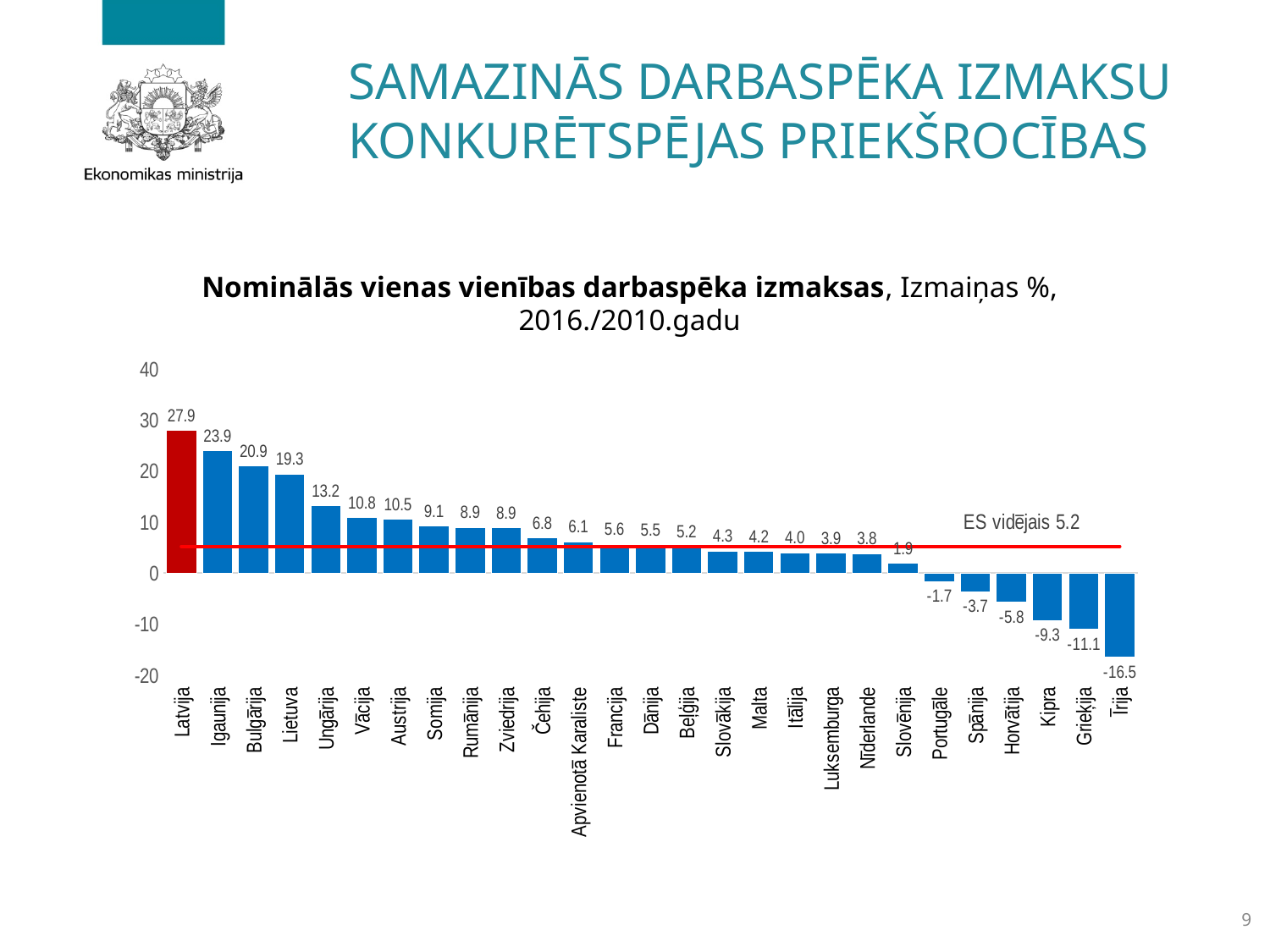
Which country has the lowest value? Īrija What is the value for Īrija? -16.5 Is the value for Lietuva greater or less than 10? greater How many countries are shown in the chart? 27 What is the value for Apvienotā Karaliste? 6.1 What is the value for Ungārija? 13.2 Which country has the highest value? Latvija What is the value for Latvija? 27.9 What value does the red horizontal line labelled 'ES vidējais' mark? 5.2 What is the difference between the values for Latvija and Igaunija? 4.0 What kind of chart is this? bar chart Which is larger, the value for Vācija or the value for Austrija? Vācija